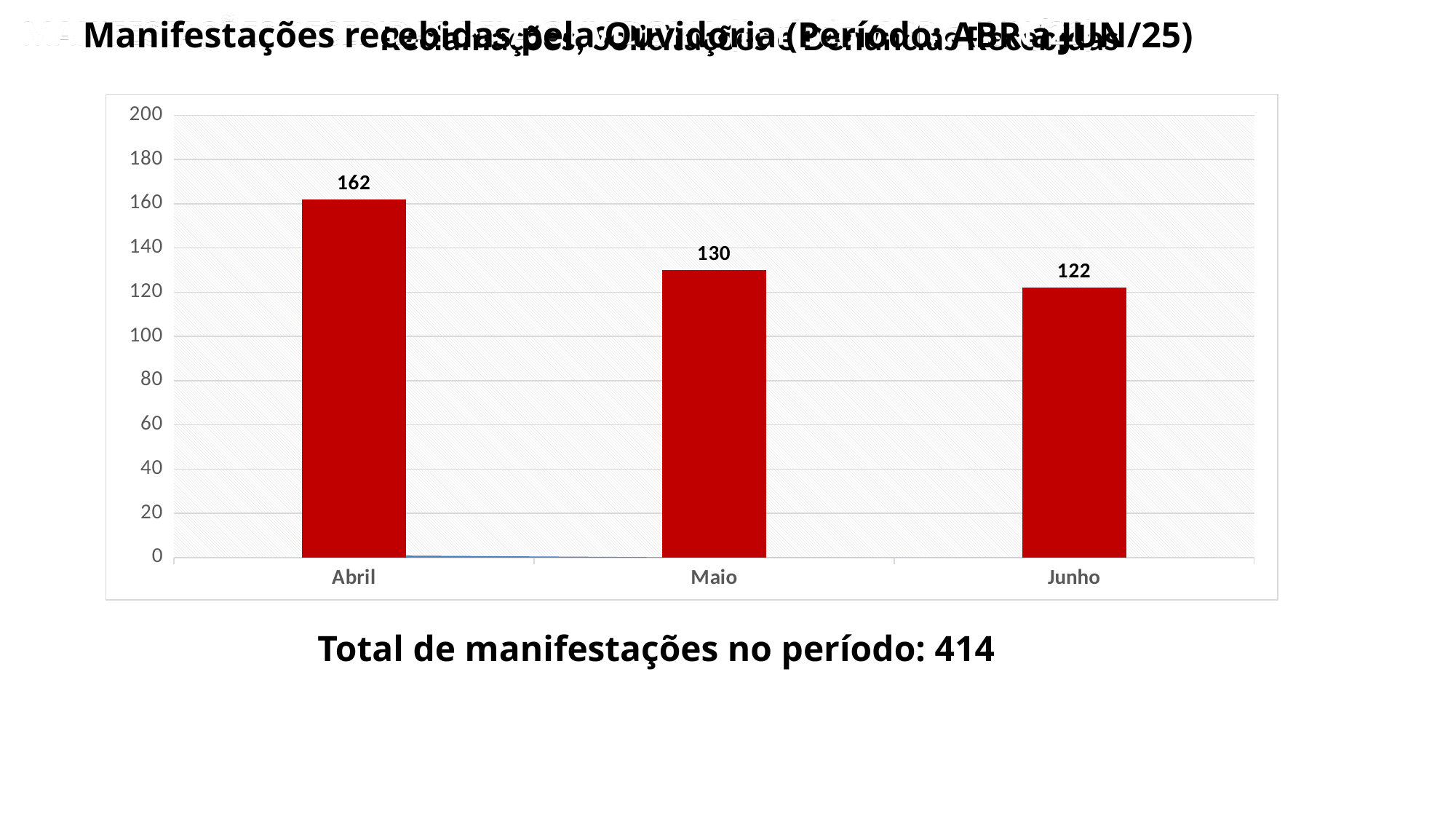
Which month has the highest value? Abril What is the value for Abril? 162 What is the difference between the values for Maio and Junho? 8 Do the values rise or fall from Abril to Junho? fall What is the difference between the values for Abril and Maio? 32 Which month has the lowest value? Junho What is the value for Maio? 130 Which is larger, the value for Abril or the value for Junho? Abril What kind of chart is shown on the slide? bar chart How many months are shown on the x axis? 3 Is the value for Maio greater or less than 140? less What is the value for Junho? 122